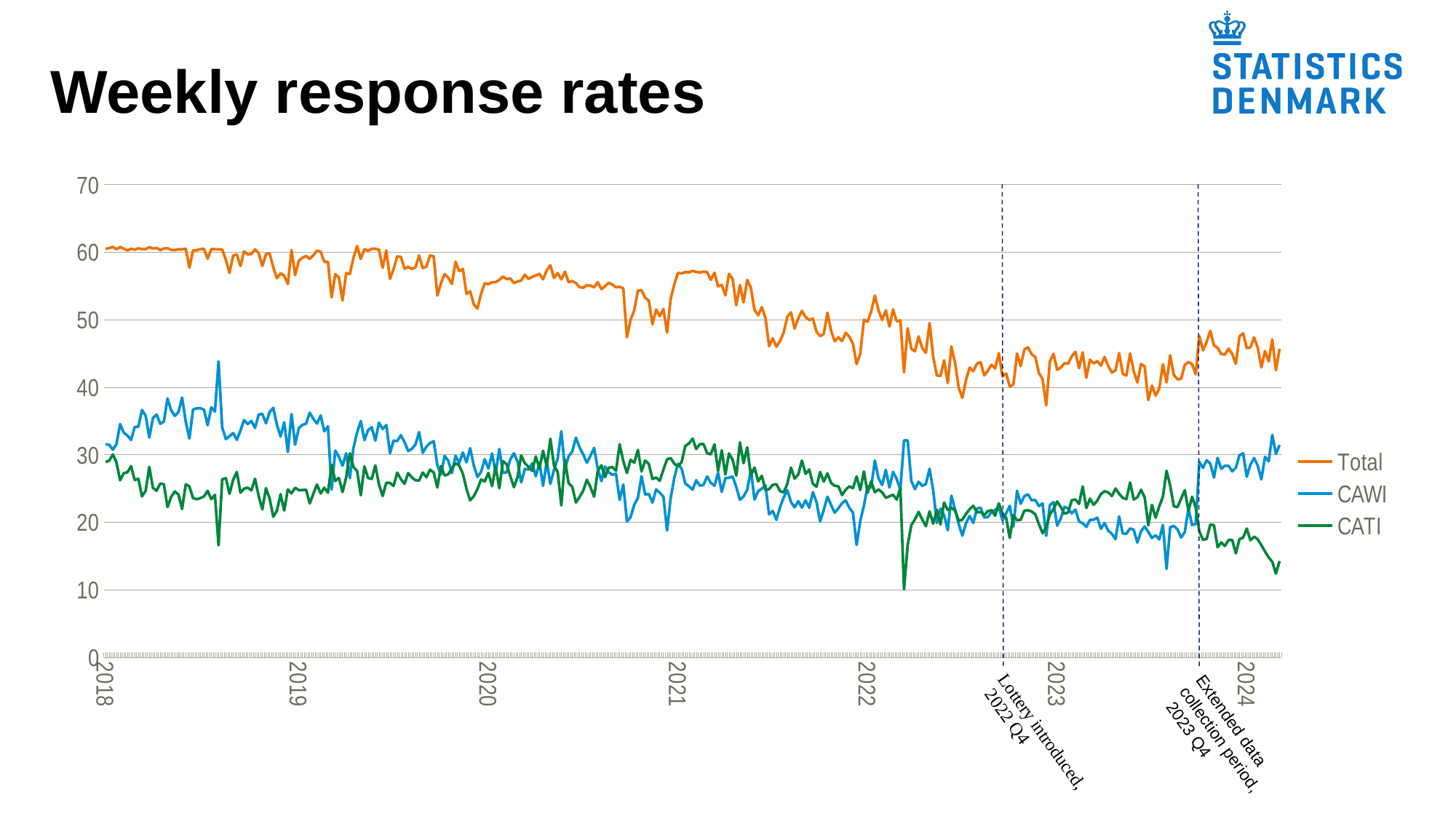
What colour is the CATI line? Green Does the CATI response rate rise or fall from 2018 to 2024? Fall Is the value for Total at the end of 2024 greater or less than 40? greater Which series has the lowest value at the end of the chart in 2024? CATI What event does the first dashed vertical line mark? Lottery introduced, 2022 Q4 Which series has the highest values throughout the chart? Total How many series does the legend list? 3 At the end of 2024, which is larger: the CAWI value or the CATI value? CAWI Is the value for Total at the start of 2018 greater or less than 50? greater Does the Total response rate rise or fall from 2018 to 2024? Fall What kind of chart is shown on the slide? Line chart Is the value for CATI at the end of 2024 greater or less than 20? less